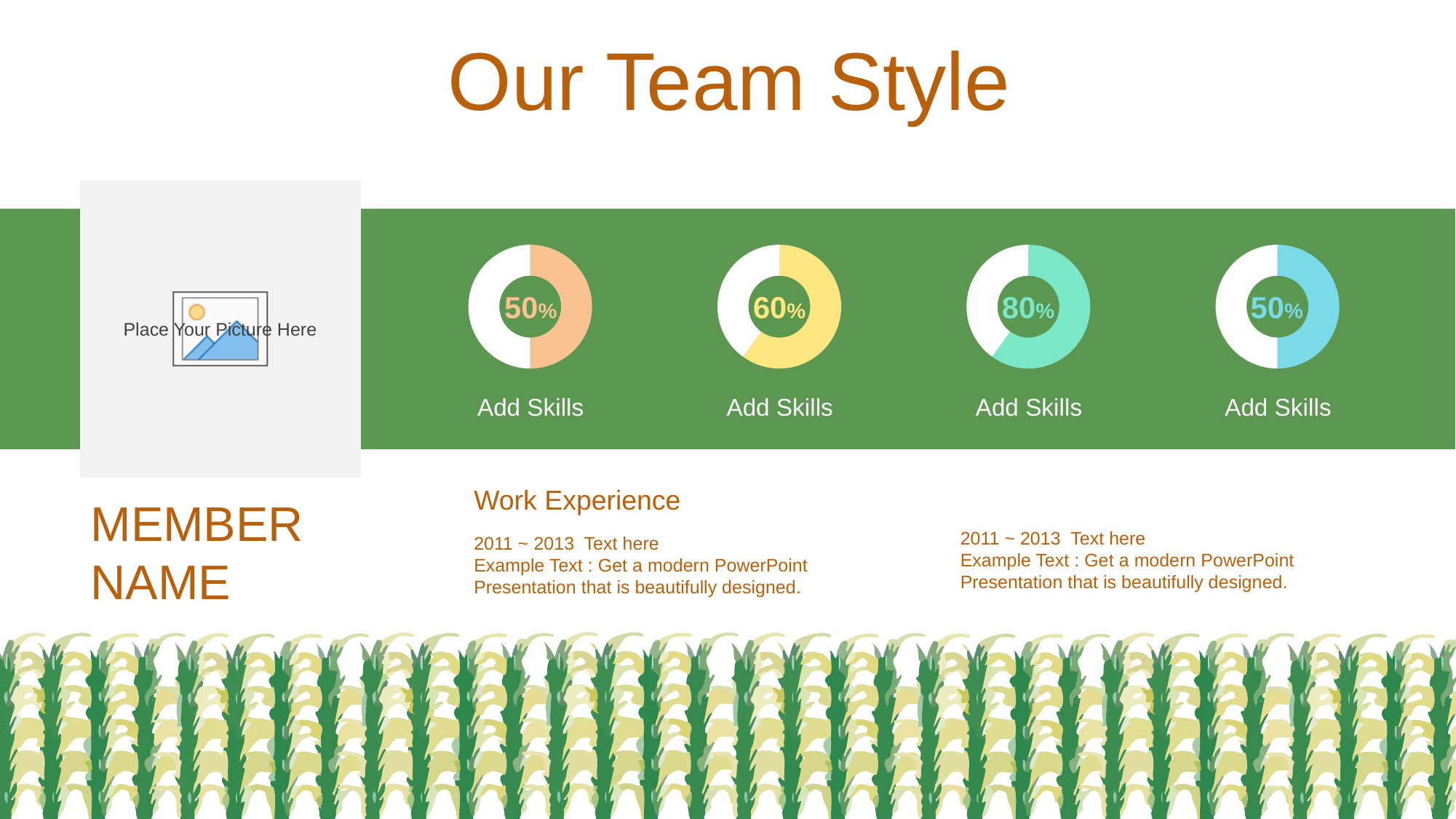
What label appears beneath each of the four doughnut charts? Add Skills What value is shown in the third doughnut chart from the left (green)? 80% What value is shown in the second doughnut chart from the left (yellow)? 60% What is the difference between the value in the third doughnut chart (80%) and the leftmost doughnut chart (50%)? 30% What value is shown in the leftmost doughnut chart (orange)? 50% What value is shown in the rightmost doughnut chart (blue)? 50% Which is larger: the value in the second doughnut chart (yellow) or the value in the rightmost doughnut chart (blue)? The second doughnut chart (yellow), 60% How many doughnut charts are shown on the slide? 4 What colour is the filled portion of the third doughnut chart from the left? Green What kind of chart is used to display the skill percentages on the slide? Doughnut chart Which of the four doughnut charts shows the highest percentage? The third from the left (green), 80% What is the difference between the value in the third doughnut chart (80%) and the second doughnut chart (60%)? 20%